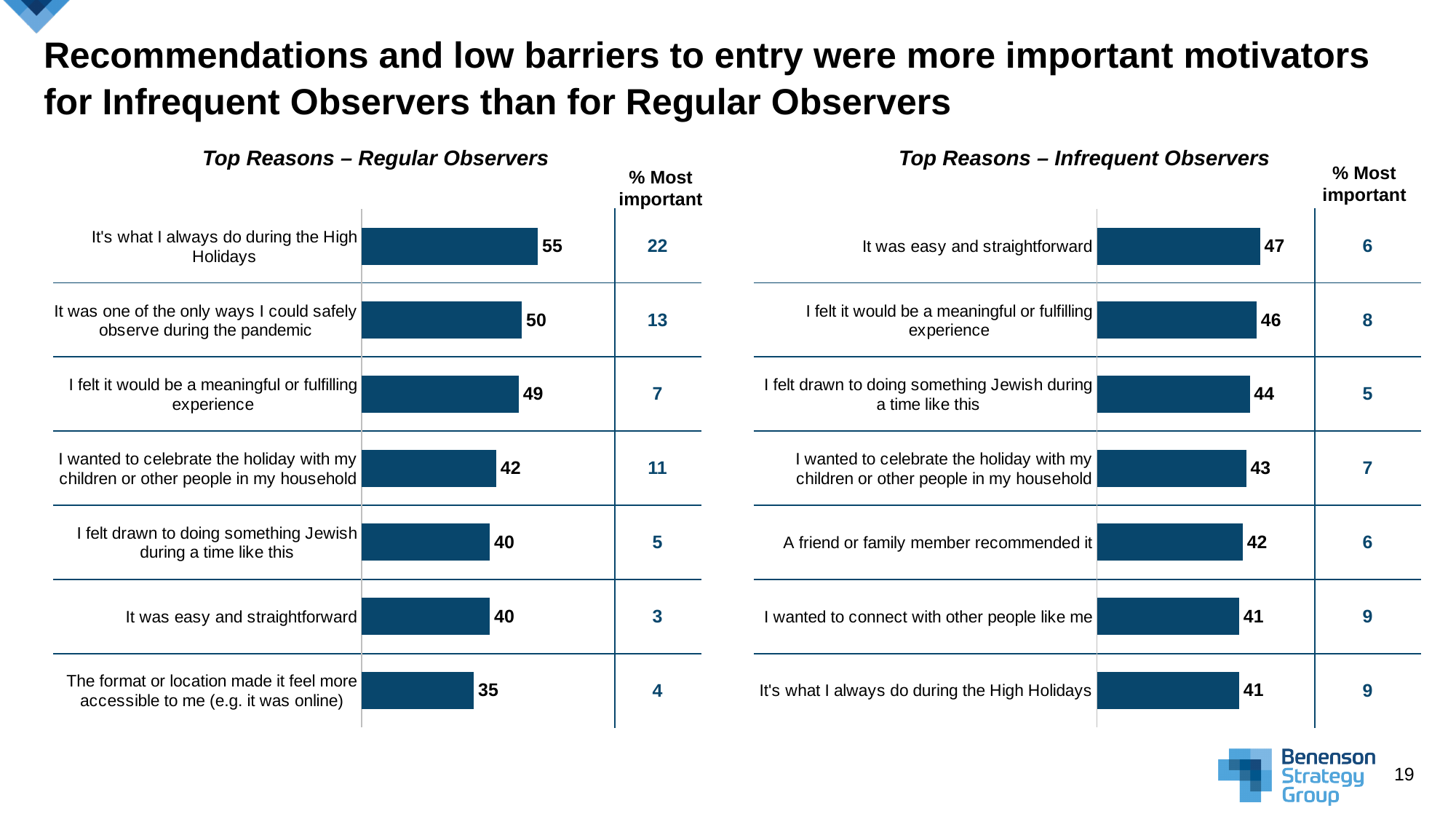
In the 'Top Reasons – Infrequent Observers' chart, which reason has the highest value? It was easy and straightforward In the 'Top Reasons – Regular Observers' chart, what is the difference between the values for 'It's what I always do during the High Holidays' and 'The format or location made it feel more accessible to me (e.g. it was online)'? 20 In the 'Top Reasons – Regular Observers' chart, which reason has the lowest value? The format or location made it feel more accessible to me (e.g. it was online) In the 'Top Reasons – Infrequent Observers' chart, what is the difference between the values for 'It was easy and straightforward' and 'I wanted to connect with other people like me'? 6 In the 'Top Reasons – Regular Observers' chart, what is the value for 'It's what I always do during the High Holidays'? 55 In the 'Top Reasons – Infrequent Observers' chart, what is the value for 'A friend or family member recommended it'? 42 In the 'Top Reasons – Regular Observers' chart, what is the '% Most important' value for 'It's what I always do during the High Holidays'? 22 In the 'Top Reasons – Infrequent Observers' chart, what is the '% Most important' value for 'I wanted to connect with other people like me'? 9 How many reasons are shown in the 'Top Reasons – Regular Observers' chart? 7 What kind of chart is the 'Top Reasons – Infrequent Observers' chart? Bar chart In the 'Top Reasons – Regular Observers' chart, which reason has the highest value? It's what I always do during the High Holidays Which is larger: the value for 'It was easy and straightforward' in the Regular Observers chart or in the Infrequent Observers chart? Infrequent Observers